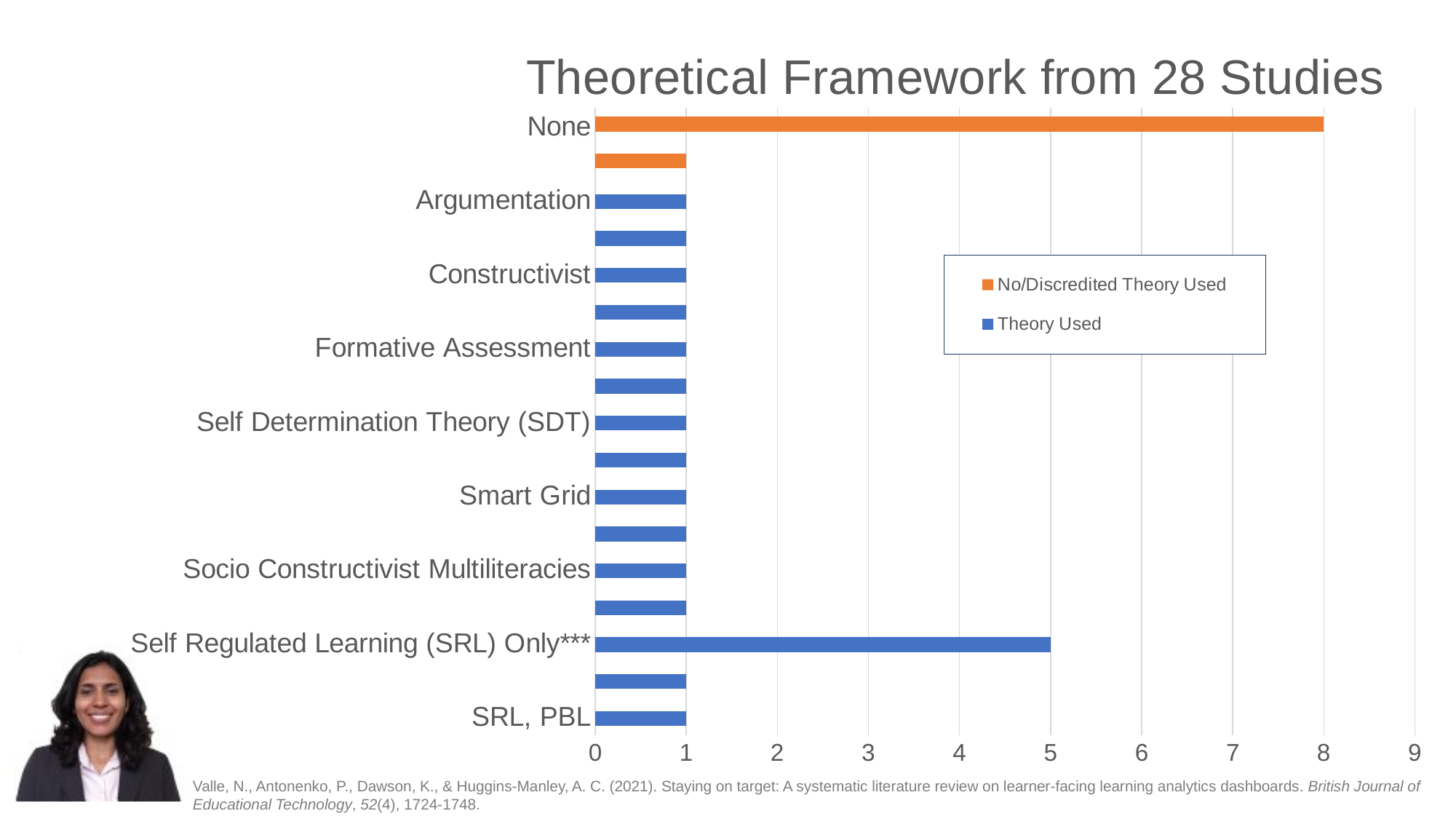
What is the value for Smart Grid? 1 What colour represents the series No/Discredited Theory Used in the legend? orange Which category has the highest value? None What kind of chart is shown on the slide? bar chart What is the difference between the values for Self Regulated Learning (SRL) Only*** and Smart Grid? 4 What is the value for Argumentation? 1 Is the value for None greater or less than 5? greater How many series does the legend list? 2 What is the value for Self Regulated Learning (SRL) Only***? 5 Which is larger, the value for Self Regulated Learning (SRL) Only*** or the value for Constructivist? Self Regulated Learning (SRL) Only*** What is the difference between the values for None and Self Regulated Learning (SRL) Only***? 3 What is the value for None? 8